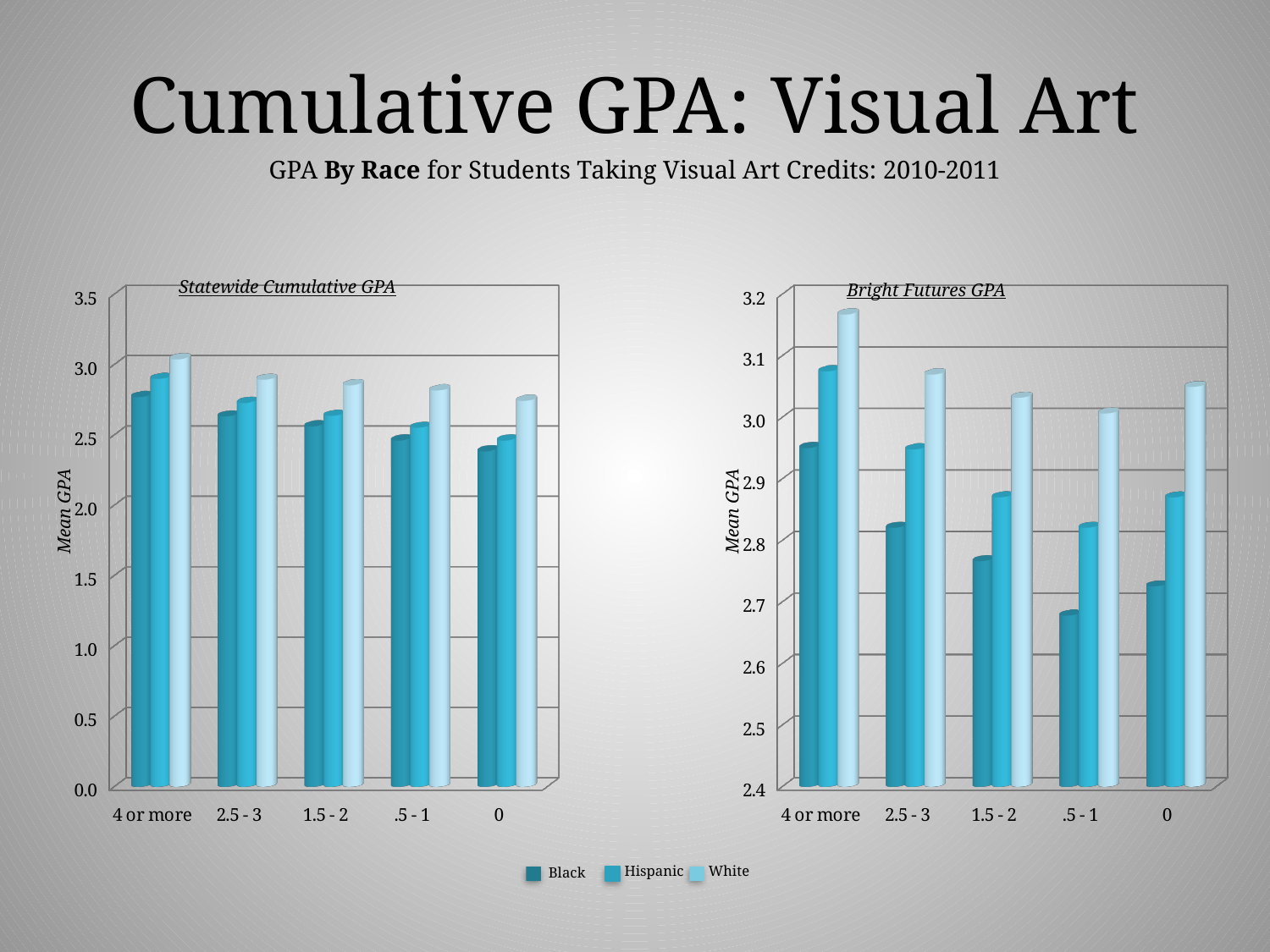
In the Statewide Cumulative GPA chart, do the Black bars rise or fall from '4 or more' to '0'? fall In the Bright Futures GPA chart, which category has the lowest bar for Black students? .5 - 1 What kind of chart is the Statewide Cumulative GPA chart? bar chart How many series does the legend list? 3 In the Bright Futures GPA chart, is the value for White students in the '4 or more' category greater or less than 3.1? greater In the Statewide Cumulative GPA chart, is the value for Black students in the '4 or more' category greater or less than 2.5? greater In the Statewide Cumulative GPA chart, which race has the highest bar in the '4 or more' category? White In the Bright Futures GPA chart, which is larger for Black students: the '4 or more' category or the '0' category? 4 or more In the Statewide Cumulative GPA chart, is the value for Black students in the '0' category greater or less than 2.5? less How many credit categories are shown on the x axis of the Bright Futures GPA chart? 5 What is the lowest value shown on the y axis of the Bright Futures GPA chart? 2.4